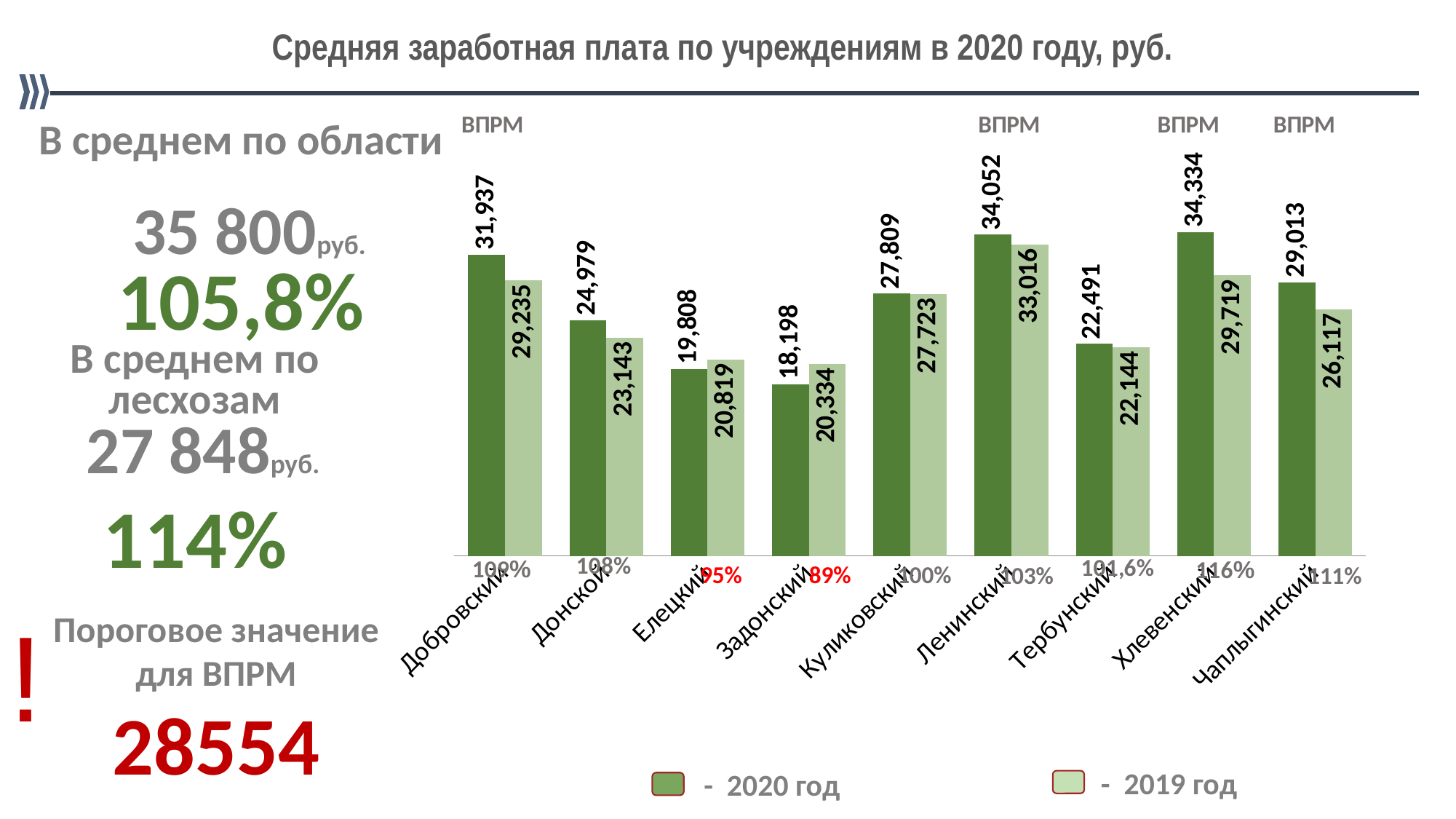
How many institutions are shown on the x axis of the chart? 9 What is the difference between the 2020 and 2019 values for Хлевенский? 4,615 Which institution has the highest 2020 value? Хлевенский Which is larger for Елецкий, the 2020 value or the 2019 value? 2019 value What is the 2019 value shown for Хлевенский? 29,719 How many series does the legend list? 2 Which institution has the lowest 2020 value? Задонский What is the difference between the 2020 and 2019 values for Добровский? 2,702 What is the 2020 value shown for Задонский? 18,198 What is the 2020 average salary value shown for Добровский? 31,937 What kind of chart is shown on the slide? Bar chart What is the title of the chart? Средняя заработная плата по учреждениям в 2020 году, руб.